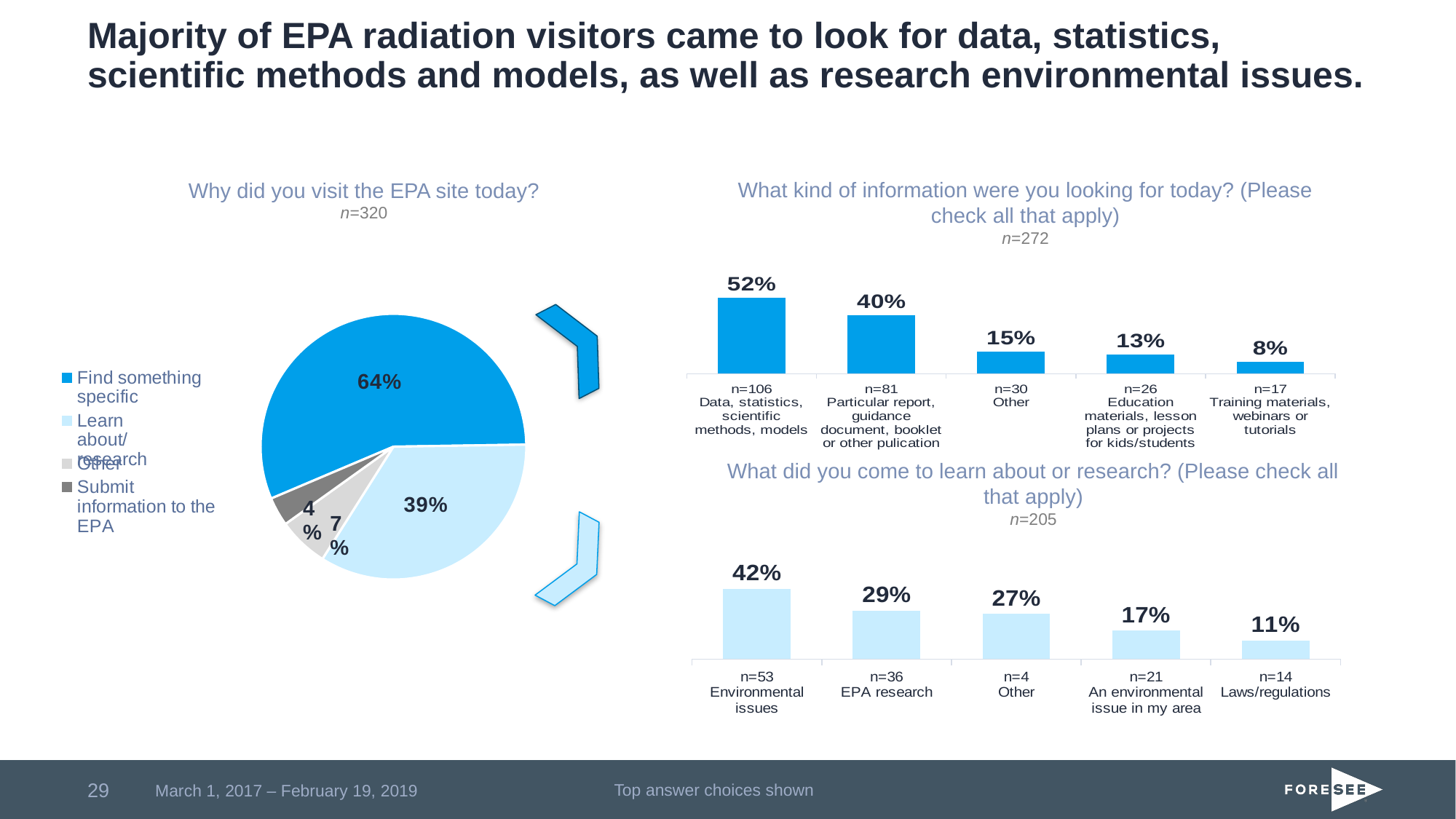
In the chart 'What kind of information were you looking for today?', what is the difference in percentage points between 'Data, statistics, scientific methods, models' and 'Particular report, guidance document, booklet or other pulication'? 12 percentage points In the chart 'What kind of information were you looking for today?', what percentage were looking for training materials, webinars or tutorials? 8% How many bars are shown in the chart 'What did you come to learn about or research?'? 5 In the pie chart 'Why did you visit the EPA site today?', what share of visitors came to find something specific? 64% In the chart 'What did you come to learn about or research?', which category has the lowest percentage? Laws/regulations In the chart 'What did you come to learn about or research?', which is larger: EPA research or An environmental issue in my area? EPA research In the chart 'What kind of information were you looking for today?', what percentage of respondents were looking for data, statistics, scientific methods, models? 52% What type of chart is 'What kind of information were you looking for today?'? Bar chart In the chart 'What did you come to learn about or research?', what percentage of respondents chose environmental issues? 42% In the pie chart 'Why did you visit the EPA site today?', what share of visitors came to learn about/research? 39% How many categories does the legend of the pie chart 'Why did you visit the EPA site today?' list? 4 In the pie chart 'Why did you visit the EPA site today?', which category has the smallest slice? Submit information to the EPA